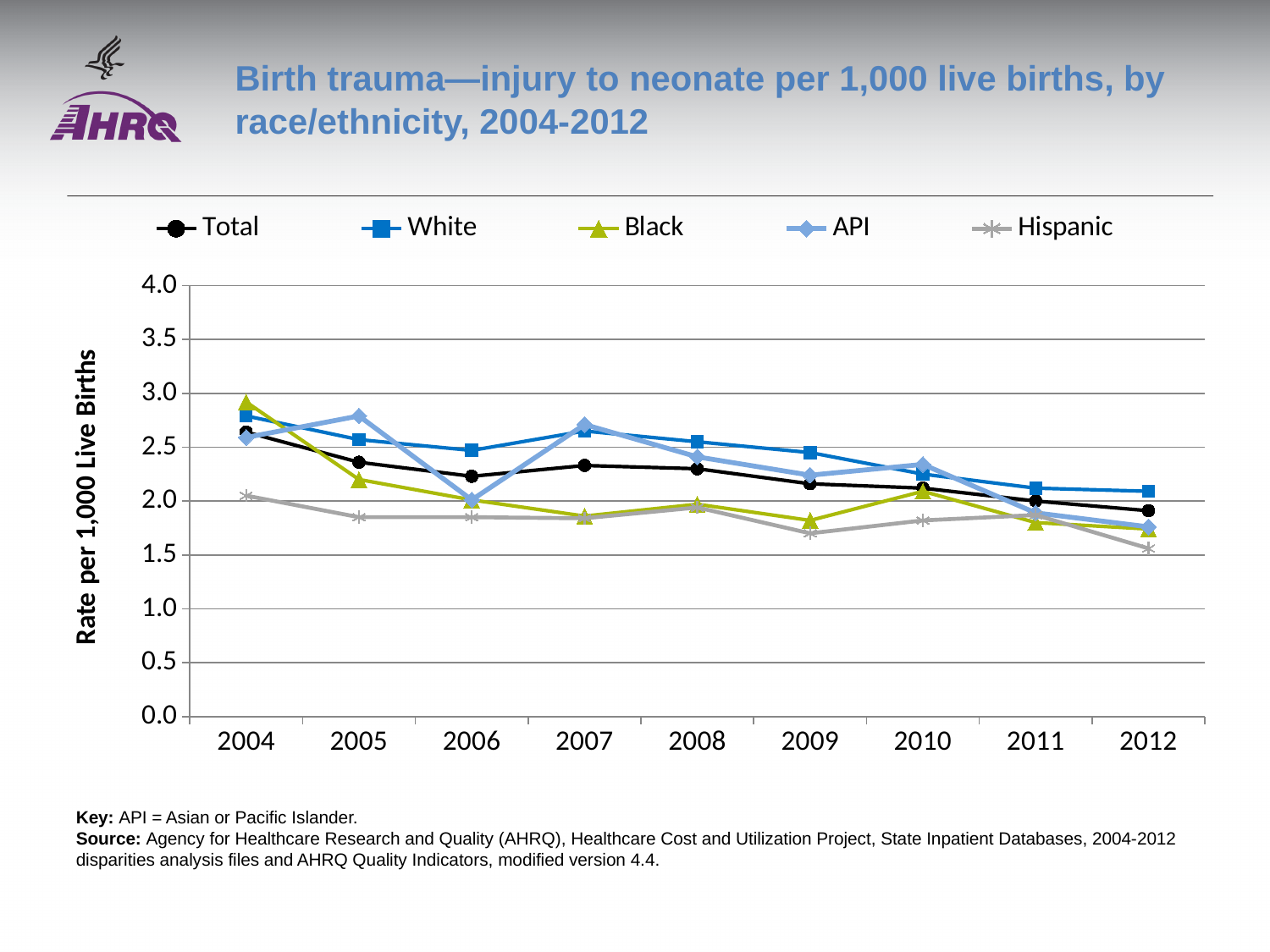
Which group has the lowest rate in 2012? Hispanic What kind of chart is shown on the slide? Line chart What is the title of the y axis? Rate per 1,000 Live Births In 2012, which is larger, the value for White or the value for Hispanic? White Is the value for Hispanic in 2012 greater or less than 2.0? less How many series does the legend list? 5 Is the value for White in 2004 greater or less than 2.5? greater How many years are shown along the x axis? 9 Is the value for Black in 2004 greater or less than 2.5? greater In 2006, which is larger, the value for White or the value for API? White Does the Total series rise or fall from 2004 to 2012? Falls